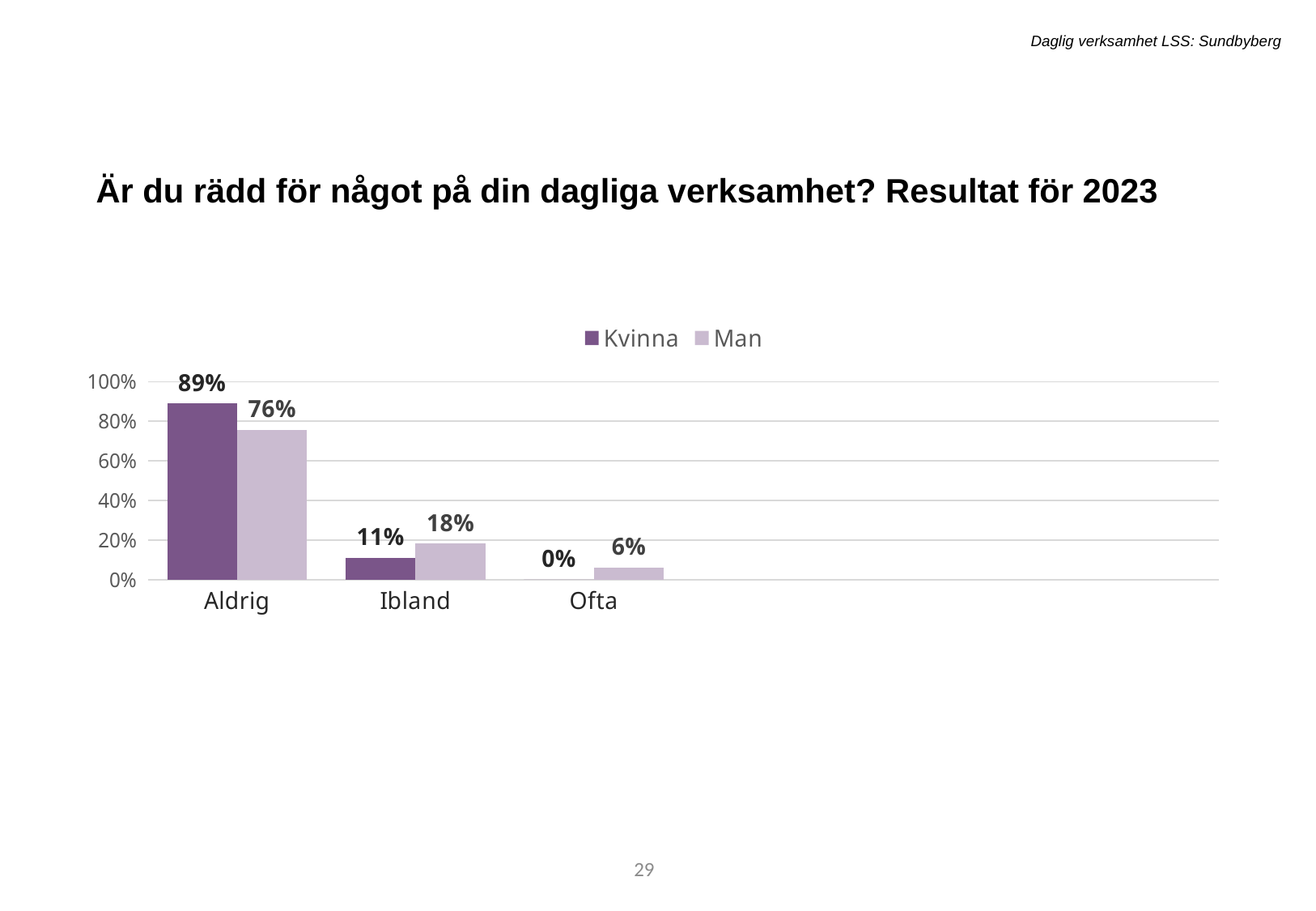
Which category has the lowest value for Kvinna? Ofta How many series does the legend list? 2 What is the value for Man in the Ofta category? 6% What is the value for Kvinna in the Ibland category? 11% What is the value for Man in the Aldrig category? 76% How many categories are shown on the x axis? 3 In the Ibland category, which series has the larger value, Kvinna or Man? Man Do the values for Kvinna rise or fall from Aldrig to Ofta? Fall What is the value for Kvinna in the Aldrig category? 89% What kind of chart is shown on the slide? Bar chart Which category has the highest value for Man? Aldrig What is the difference between the Kvinna and Man values in the Aldrig category? 13%